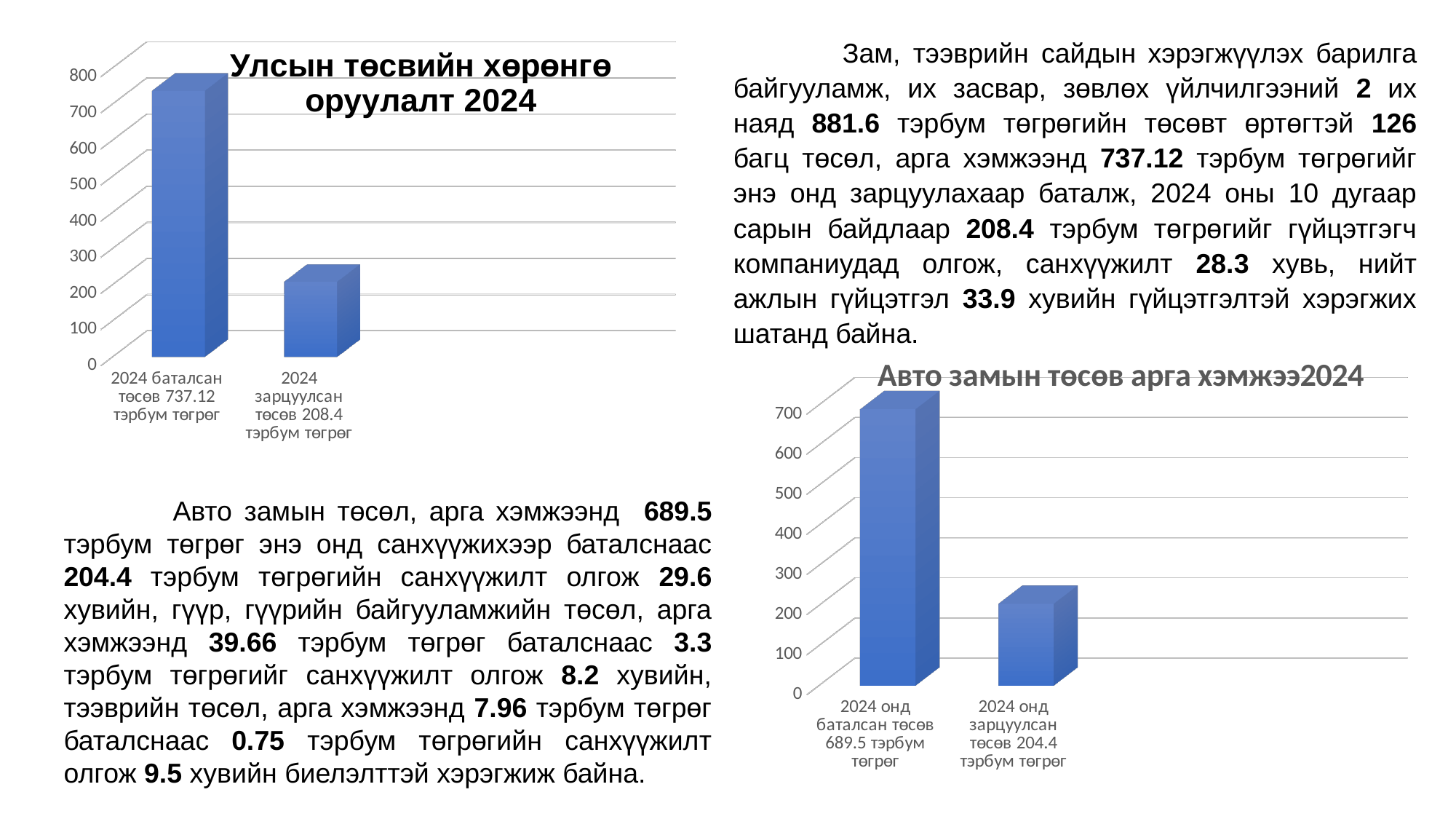
On the chart titled 'Улсын төсвийн хөрөнгө оруулалт 2024', which bar is the highest? 2024 баталсан төсөв What type of chart is the chart titled 'Улсын төсвийн хөрөнгө оруулалт 2024'? Bar chart On the chart titled 'Улсын төсвийн хөрөнгө оруулалт 2024', what is the value of the approved budget (баталсан төсөв) for 2024? 737.12 тэрбум төгрөг On the chart titled 'Авто замын төсөв арга хэмжээ2024', is the value for the approved budget (баталсан төсөв) greater or less than 700? less How many bars are shown on the chart titled 'Авто замын төсөв арга хэмжээ2024'? 2 On the chart titled 'Авто замын төсөв арга хэмжээ2024', what is the value of the spent budget (зарцуулсан төсөв) for 2024? 204.4 тэрбум төгрөг On the chart titled 'Авто замын төсөв арга хэмжээ2024', what is the value of the approved budget (баталсан төсөв) for 2024? 689.5 тэрбум төгрөг On the chart titled 'Улсын төсвийн хөрөнгө оруулалт 2024', is the value for the approved budget (баталсан төсөв) greater or less than 700? greater On the chart titled 'Авто замын төсөв арга хэмжээ2024', what is the difference between the approved budget and the spent budget? 485.1 тэрбум төгрөг On the chart titled 'Улсын төсвийн хөрөнгө оруулалт 2024', what is the value of the spent budget (зарцуулсан төсөв) for 2024? 208.4 тэрбум төгрөг On the chart titled 'Авто замын төсөв арга хэмжээ2024', which bar is the lowest? 2024 онд зарцуулсан төсөв On the chart titled 'Улсын төсвийн хөрөнгө оруулалт 2024', what is the difference between the approved budget and the spent budget? 528.72 тэрбум төгрөг